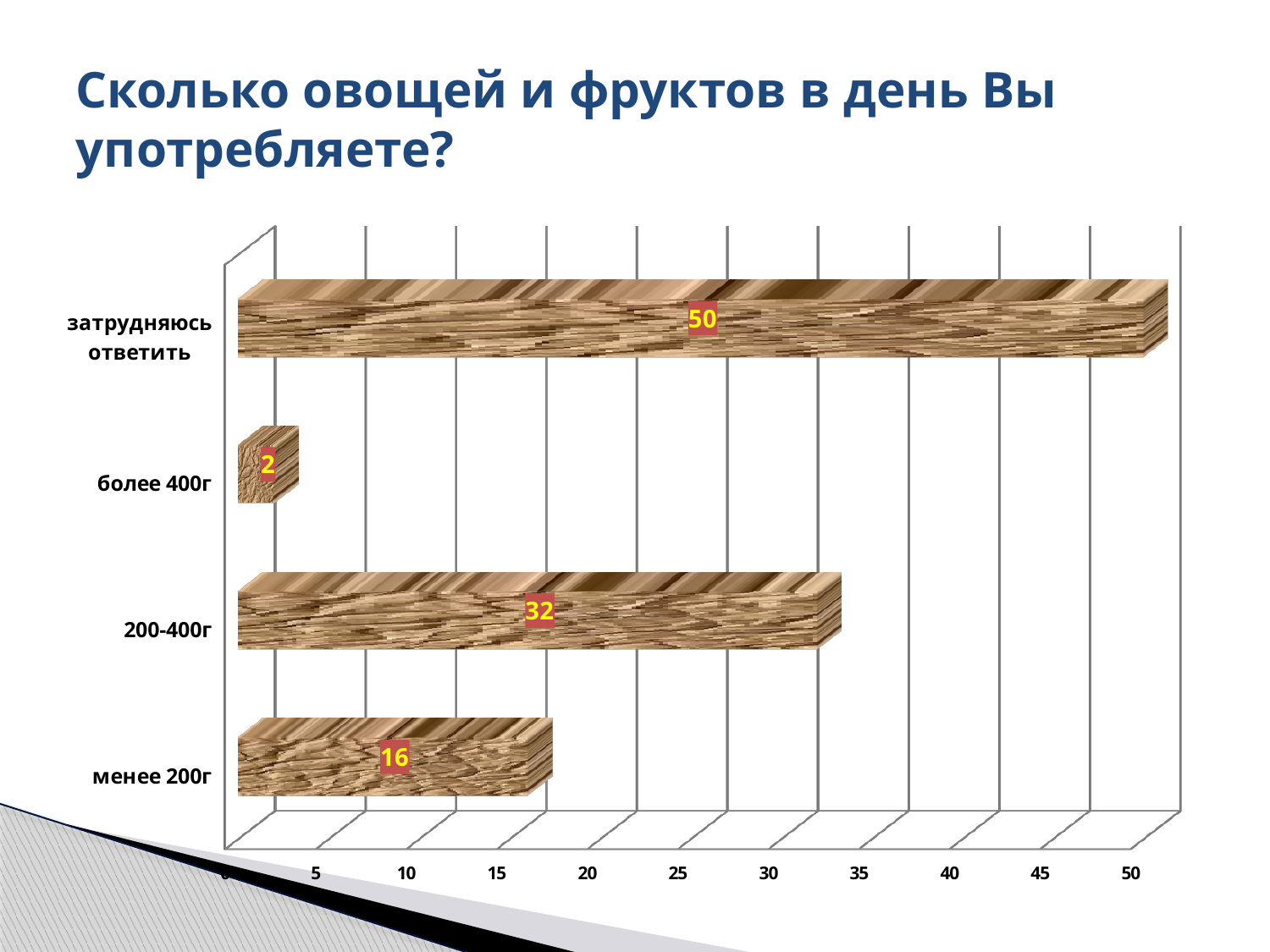
Which is larger, the value for "200-400г" or the value for "менее 200г"? 200-400г What is the value for "200-400г"? 32 What is the value for "затрудняюсь ответить"? 50 What is the title of the slide? Сколько овощей и фруктов в день Вы употребляете? What is the value for "более 400г"? 2 What is the difference between the values for "затрудняюсь ответить" and "более 400г"? 48 Which category has the lowest value? более 400г What kind of chart is shown on the slide? bar chart What is the value for "менее 200г"? 16 What is the difference between the values for "200-400г" and "менее 200г"? 16 How many categories are shown in the chart? 4 Which category has the highest value? затрудняюсь ответить